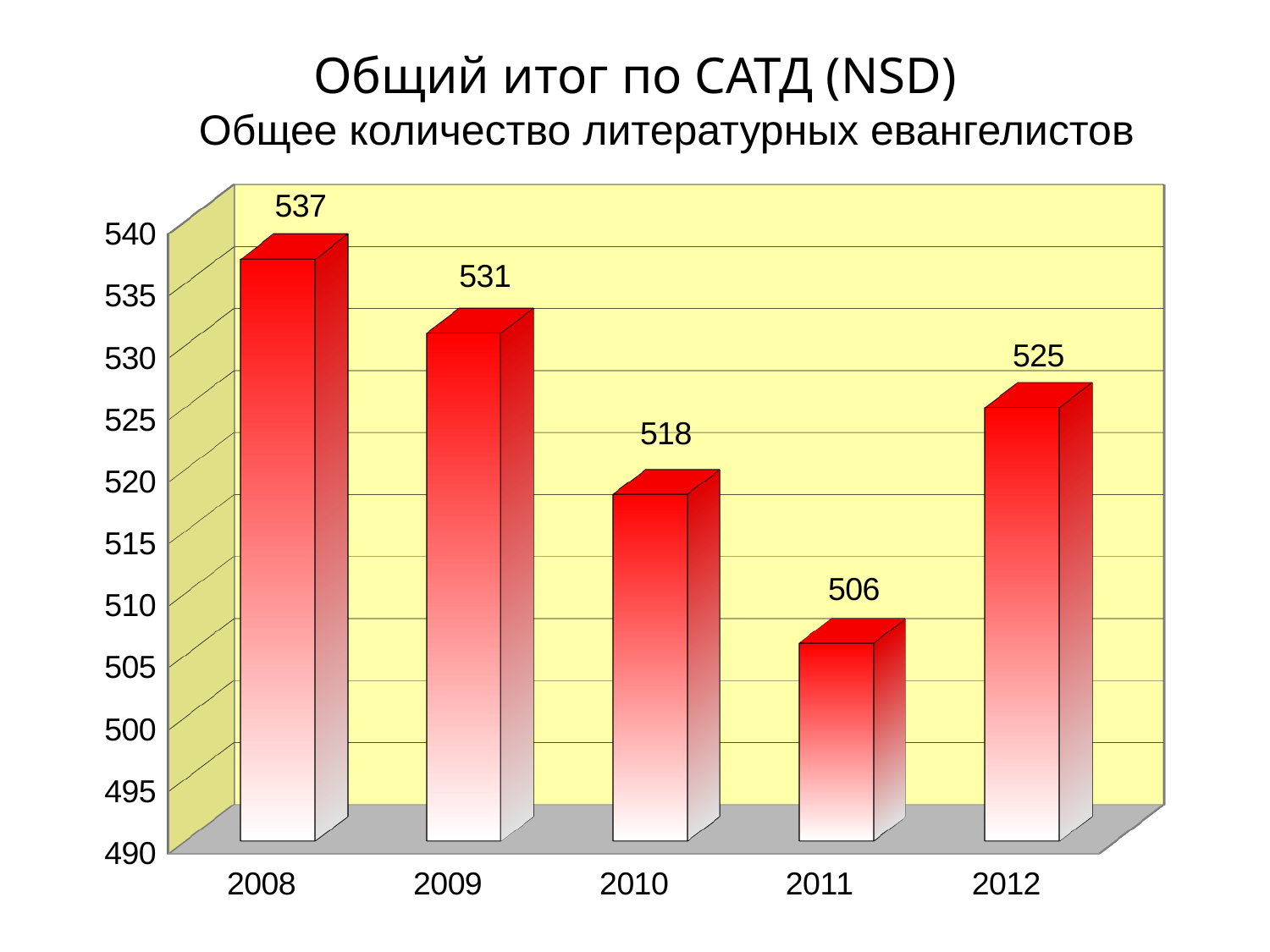
What is the value for 2008? 537 Which year has the highest value? 2008 Do the values rise or fall from 2008 to 2011? fall What is the difference between the values for 2008 and 2011? 31 How many years are shown on the x axis? 5 What is the value for 2011? 506 Which is larger, the value for 2009 or the value for 2012? 2009 Which year has the lowest value? 2011 What is the value for 2012? 525 What is the difference between the values for 2012 and 2011? 19 What kind of chart is shown on the slide? bar chart Is the value for 2010 greater or less than 520? less